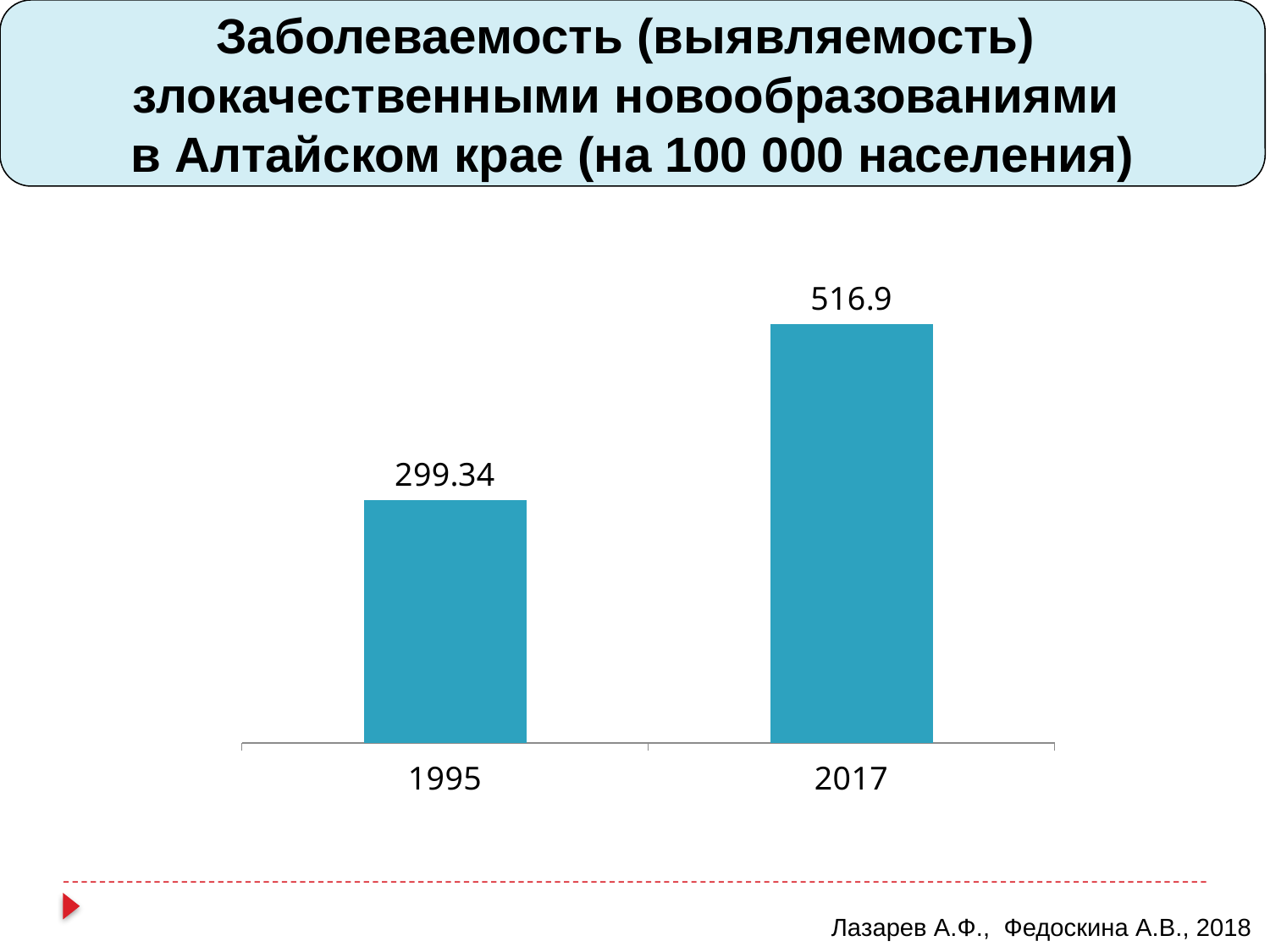
What is the value for 1995? 299.34 What kind of chart is shown on the slide? bar chart What is the value for 2017? 516.9 How many categories are shown on the x axis? 2 Per how many people of population is the incidence given, according to the slide title? 100 000 Which is larger, the value for 1995 or the value for 2017? 2017 Which year has the lowest value? 1995 What colour are the bars in the chart? blue Do the values rise or fall from 1995 to 2017? rise What is the difference between the values for 2017 and 1995? 217.56 Which year has the highest value? 2017